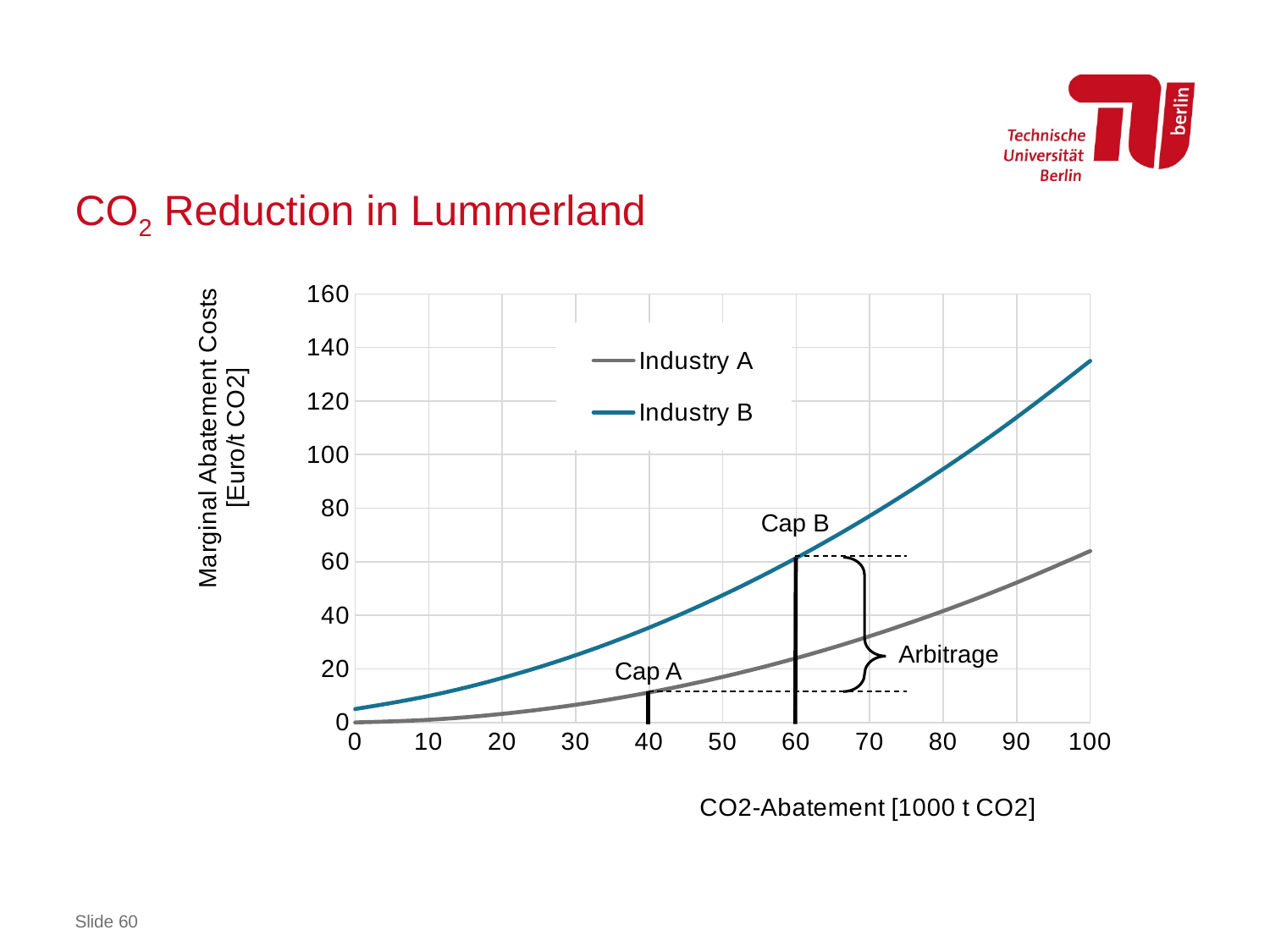
Is the value for Industry B at a CO2 abatement of 0 greater or less than 20? less Do the marginal abatement costs for Industry B rise or fall as CO2 abatement increases along the x axis? rise Is the value for Industry A at a CO2 abatement of 40 greater or less than 20? less What kind of chart is shown on the slide? line chart Is the value for Industry A at a CO2 abatement of 100 greater or less than 40? greater Which series has the higher marginal abatement cost at a CO2 abatement of 50? Industry B How many series does the legend list? 2 Do the marginal abatement costs for Industry A rise or fall as CO2 abatement increases along the x axis? rise What is the label of the x axis of the chart? CO2-Abatement [1000 t CO2] At which CO2 abatement value on the x axis is Cap B marked? 60